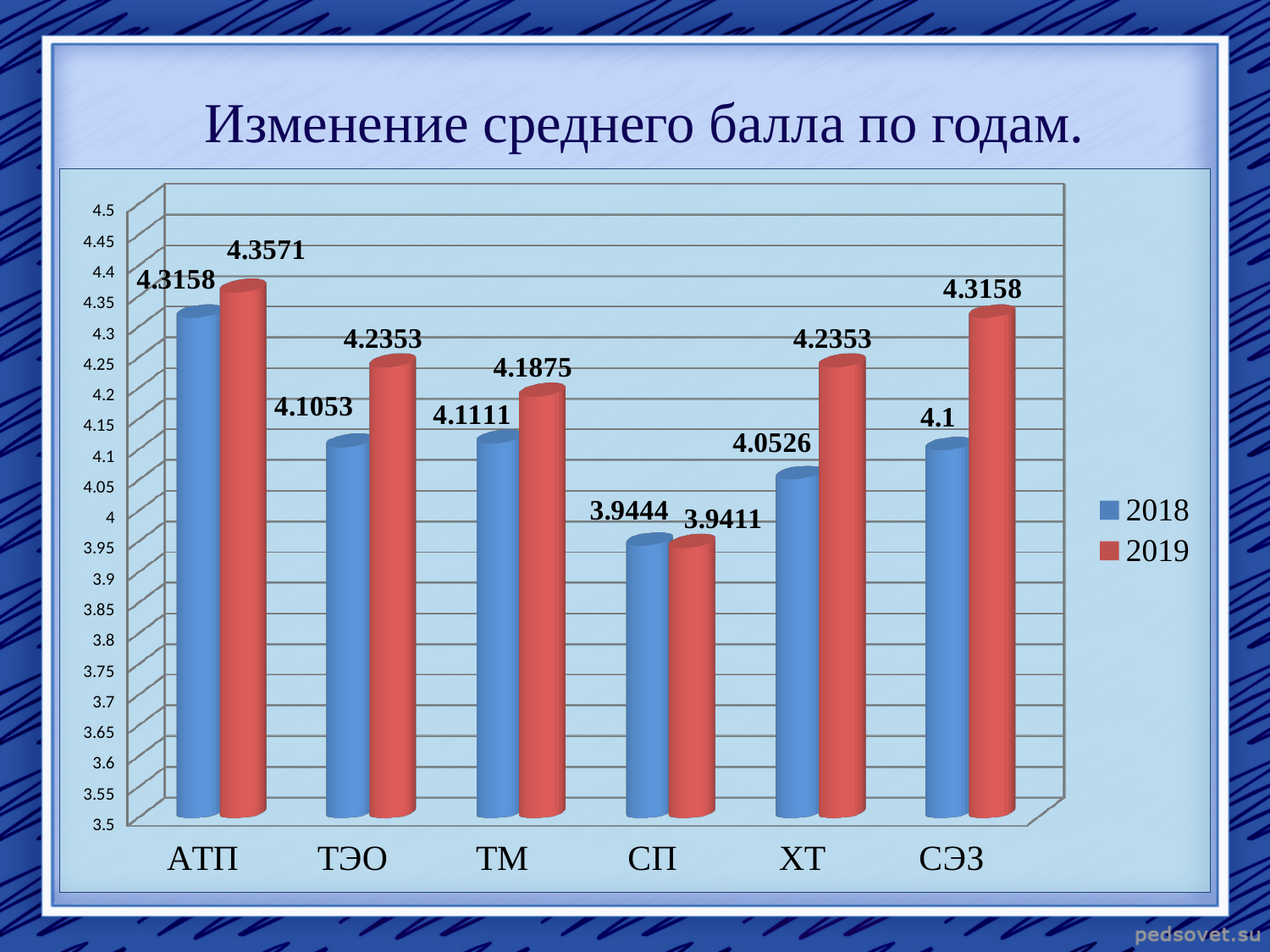
How many series does the legend list? 2 What is the difference between the 2019 and 2018 values for СЭЗ? 0.2158 How many categories are shown on the x axis? 6 What is the 2019 value for СП? 3.9411 What is the title of the chart? Изменение среднего балла по годам. What is the 2018 value for ТЭО? 4.1053 What is the difference between the 2019 and 2018 values for ХТ? 0.1827 What kind of chart is shown on the slide? Bar chart Which category has the lowest 2018 value? СП What is the 2019 value for ХТ? 4.2353 For СП, which year has the larger value, 2018 or 2019? 2018 Which category has the highest 2019 value? АТП